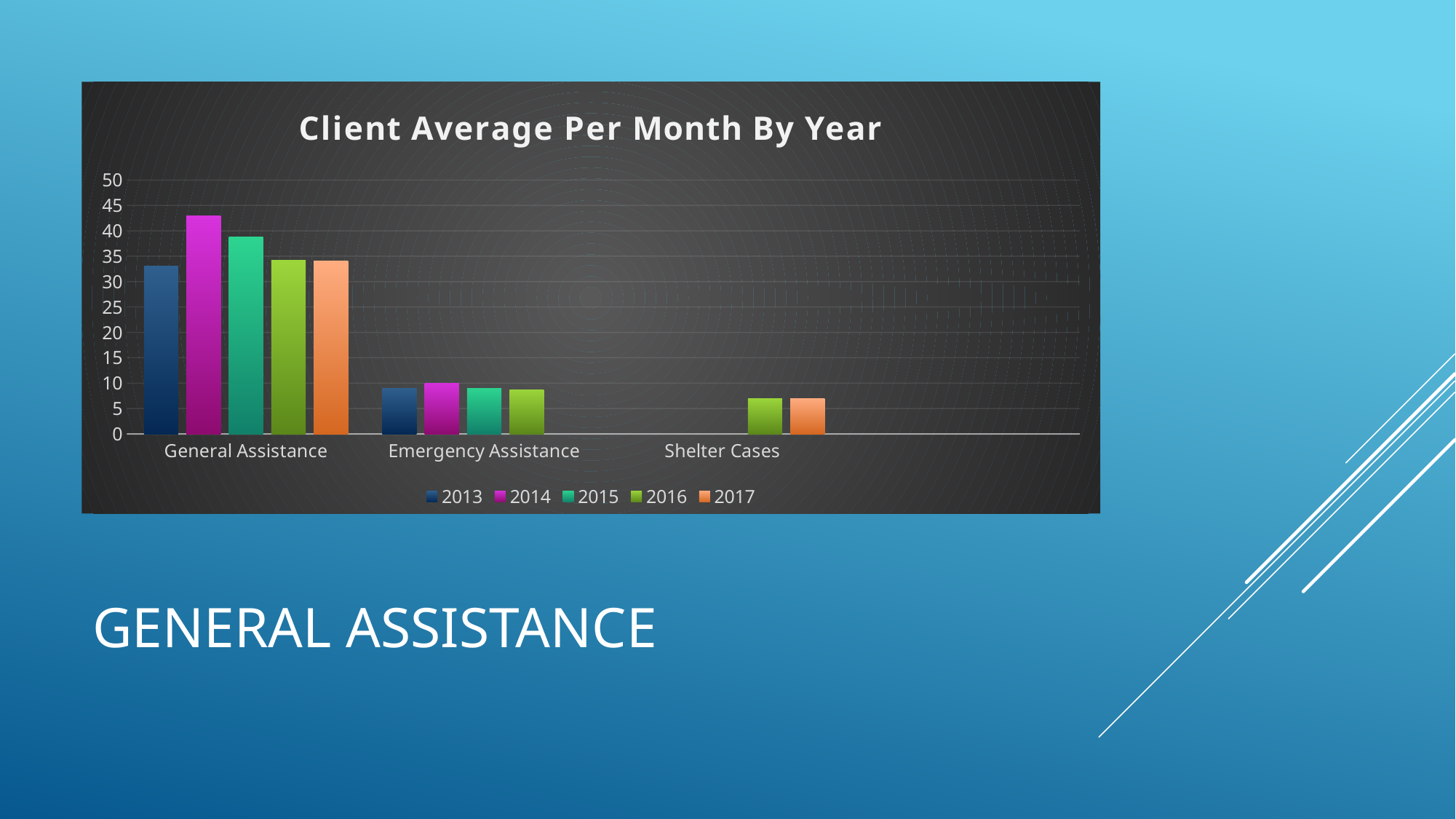
How many series does the chart's legend list? 5 What kind of chart is shown on the slide? bar chart Which category has the highest bars overall? General Assistance Which year has the highest bar for General Assistance? 2014 Is the value for 2013 in General Assistance greater or less than 30? greater Is the value for 2014 in Emergency Assistance greater or less than 15? less What is the title of the chart? Client Average Per Month By Year Which years are listed in the chart's legend? 2013, 2014, 2015, 2016, 2017 Which is larger: the 2015 value for General Assistance or the 2015 value for Emergency Assistance? General Assistance Is the value for 2016 in Shelter Cases greater or less than 10? less How many categories are shown on the x axis of the chart? 3